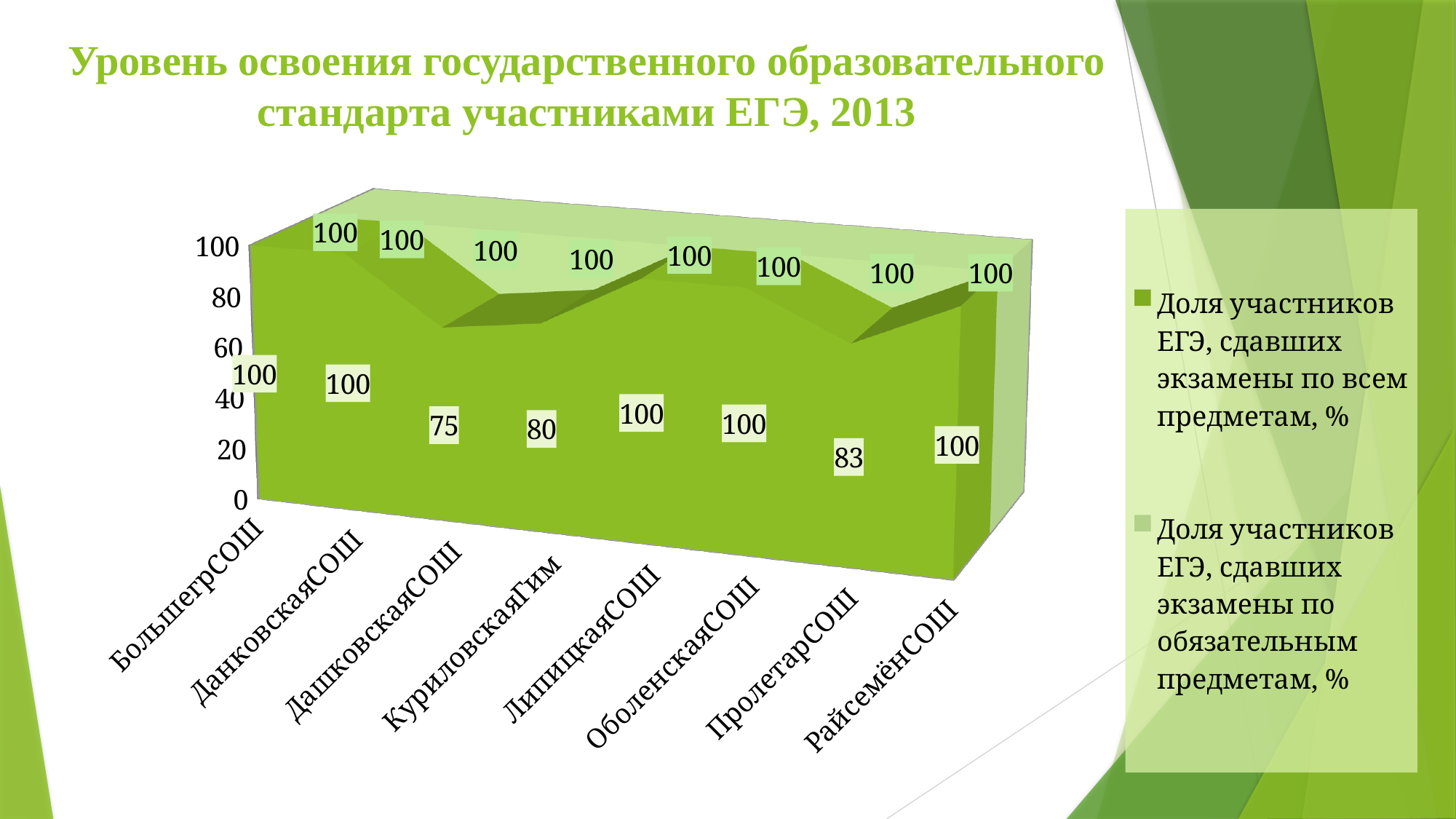
What is the difference between the two series' values for ДашковскаяСОШ? 25 What is the title of the chart on the slide? Уровень освоения государственного образовательного стандарта участниками ЕГЭ, 2013 What is the value for КуриловскаяГим in the series 'Доля участников ЕГЭ, сдавших экзамены по всем предметам, %'? 80 Which is larger for КуриловскаяГим: the value for all subjects or the value for mandatory subjects? mandatory subjects (100) What is the value for ДашковскаяСОШ in the series 'Доля участников ЕГЭ, сдавших экзамены по всем предметам, %'? 75 What kind of chart is shown on the slide? area chart What is the difference between the two series' values for ПролетарСОШ? 17 How many schools are shown on the x axis? 8 Which school has the lowest value in the series 'Доля участников ЕГЭ, сдавших экзамены по всем предметам, %'? ДашковскаяСОШ What is the value for ПролетарСОШ in the series 'Доля участников ЕГЭ, сдавших экзамены по всем предметам, %'? 83 How many series does the legend list? 2 What is the value for ПролетарСОШ in the series 'Доля участников ЕГЭ, сдавших экзамены по обязательным предметам, %'? 100